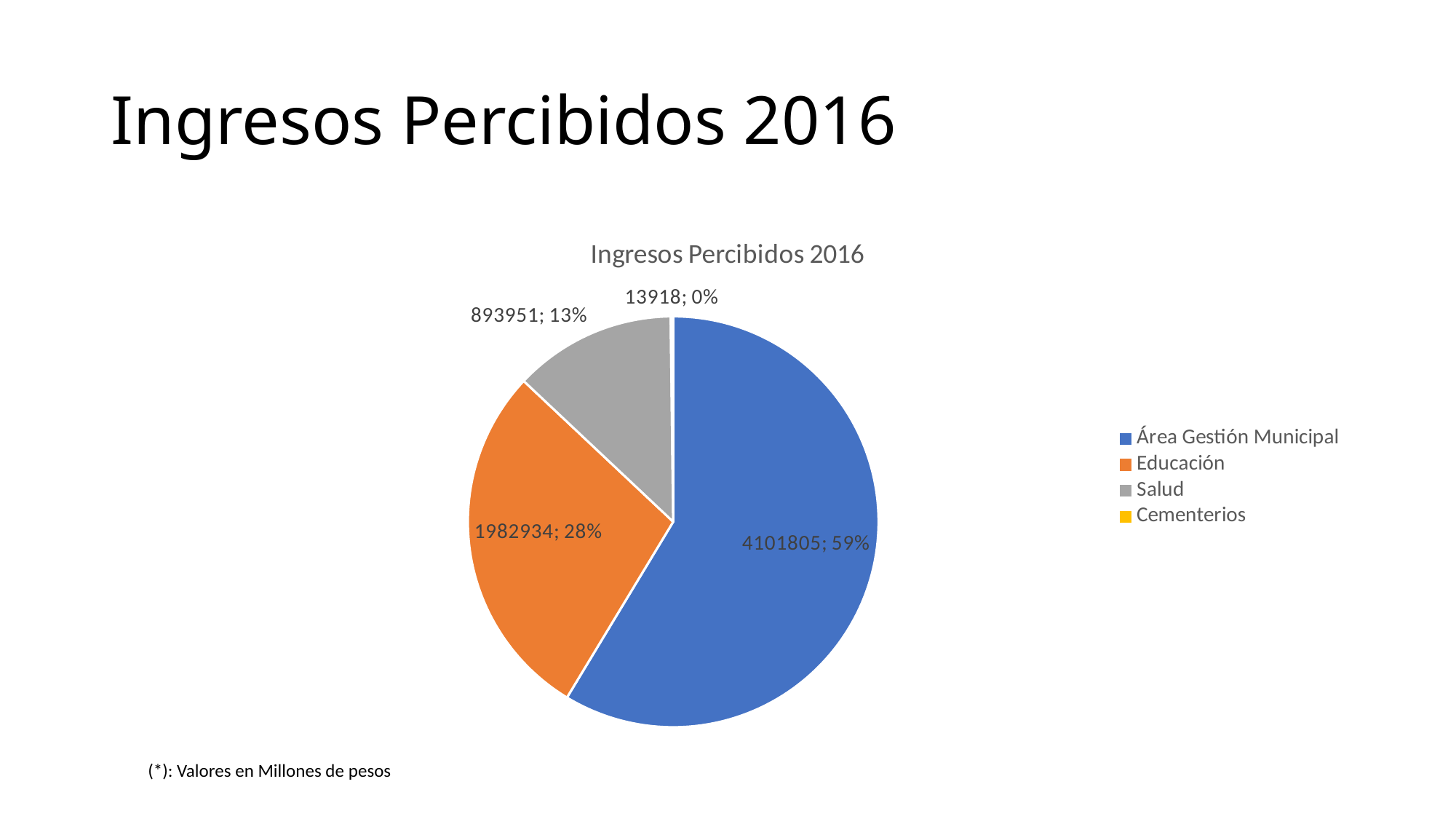
What share of the pie does Salud represent? 13% What is the value for Educación? 1982934 Which category has the smallest slice? Cementerios What is the value for Cementerios? 13918 How many categories does the legend list? 4 What type of chart is shown on the slide? Pie chart Which category has the largest slice? Área Gestión Municipal What is the value for Área Gestión Municipal? 4101805 What is the title of the chart? Ingresos Percibidos 2016 What is the value for Salud? 893951 What is the difference between the values for Área Gestión Municipal and Educación? 2118871 What share of the pie does Educación represent? 28%